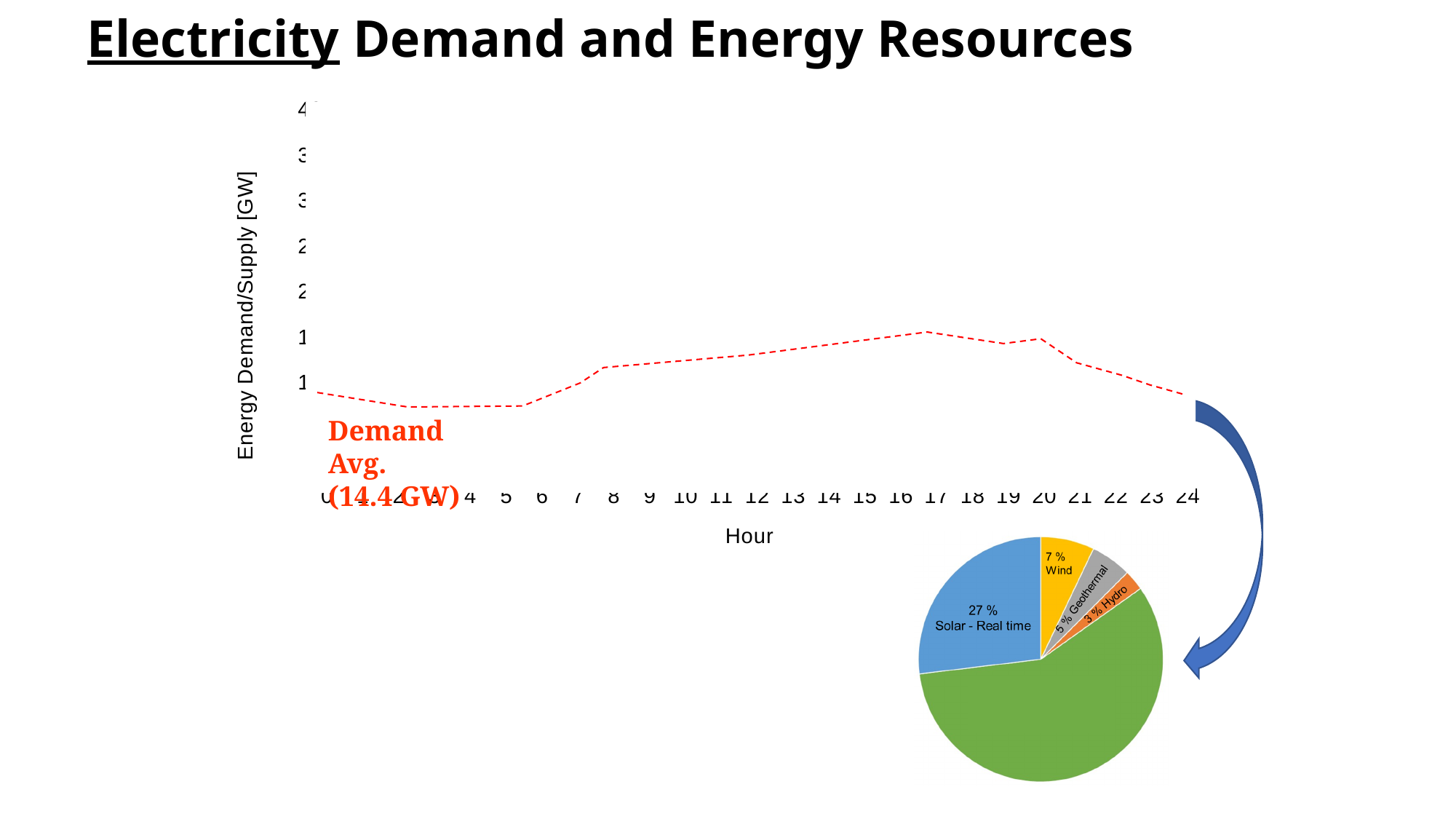
In the pie chart, what share is labelled for Wind? 7 % In the line chart, does the demand line rise or fall between hour 8 and hour 17? rise What average demand value is annotated on the line chart? 14.4 GW What kind of chart is the top chart showing demand by hour? line chart What kind of chart is the bottom-right chart showing energy resources? pie chart In the line chart, does the demand line rise or fall between hour 20 and hour 24? fall In the pie chart, what share is labelled for Geothermal? 5 % In the pie chart, which is larger, the Wind slice or the Geothermal slice? Wind In the pie chart, what share is labelled for Hydro? 3 % What is the x-axis title of the line chart? Hour In the pie chart, what is the difference between the Solar - Real time share and the Wind share? 20 % In the pie chart, what share is labelled for Solar - Real time? 27 %